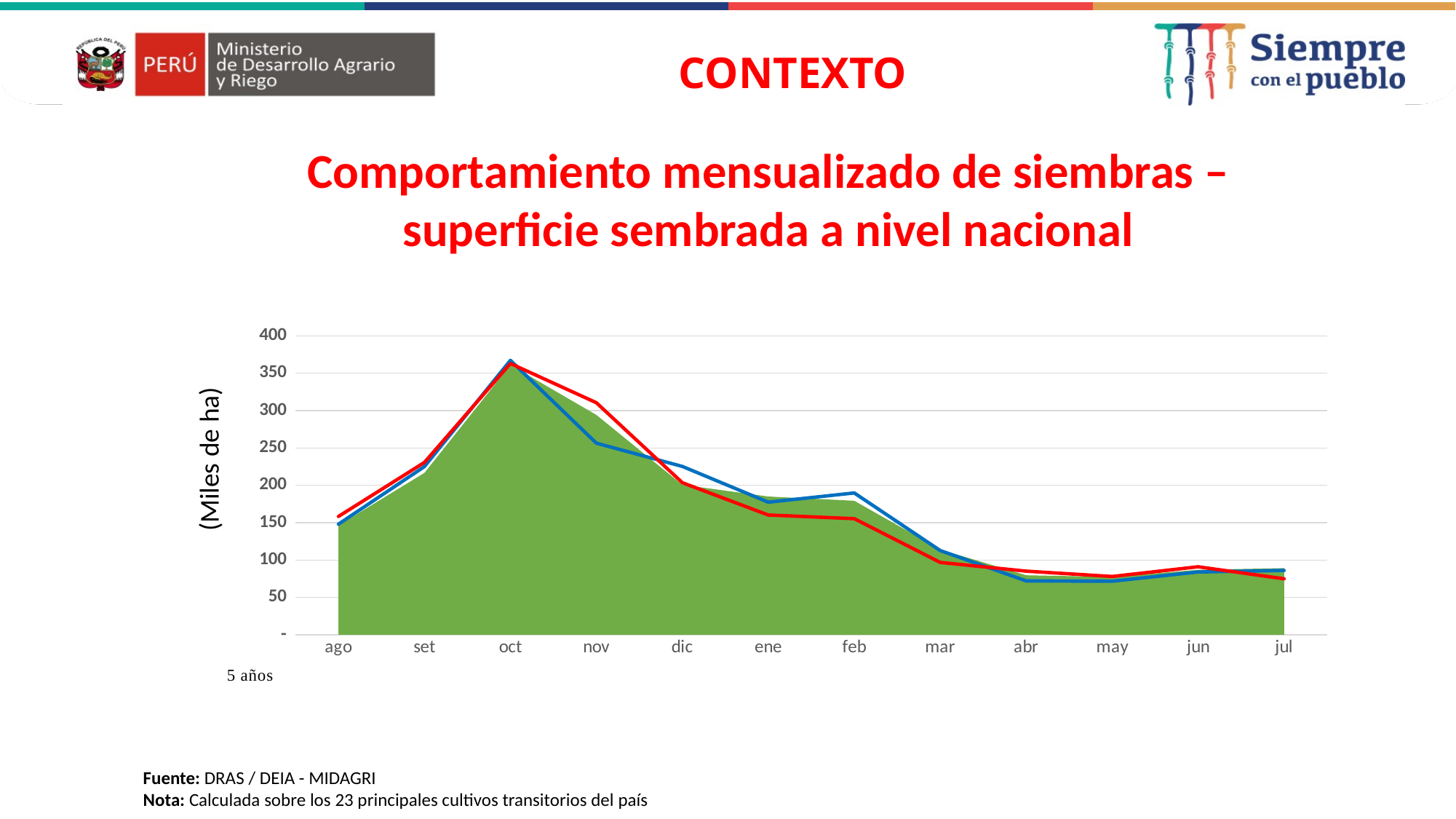
Is the value of the red line in nov greater or less than 250? greater How many data series are plotted on the chart? 3 Do the values rise or fall from oct to abr? Fall In nov, which is higher, the red line or the blue line? The red line What is the label on the y axis of the chart? (Miles de ha) In which month do all the series reach their highest value? oct In feb, which is higher, the red line or the blue line? The blue line What kind of chart is shown on the slide? An area chart with two line series Is the value of the blue line in oct greater or less than 350? greater Is the value of the blue line in abr greater or less than 100? less How many months are shown along the x axis of the chart? 12